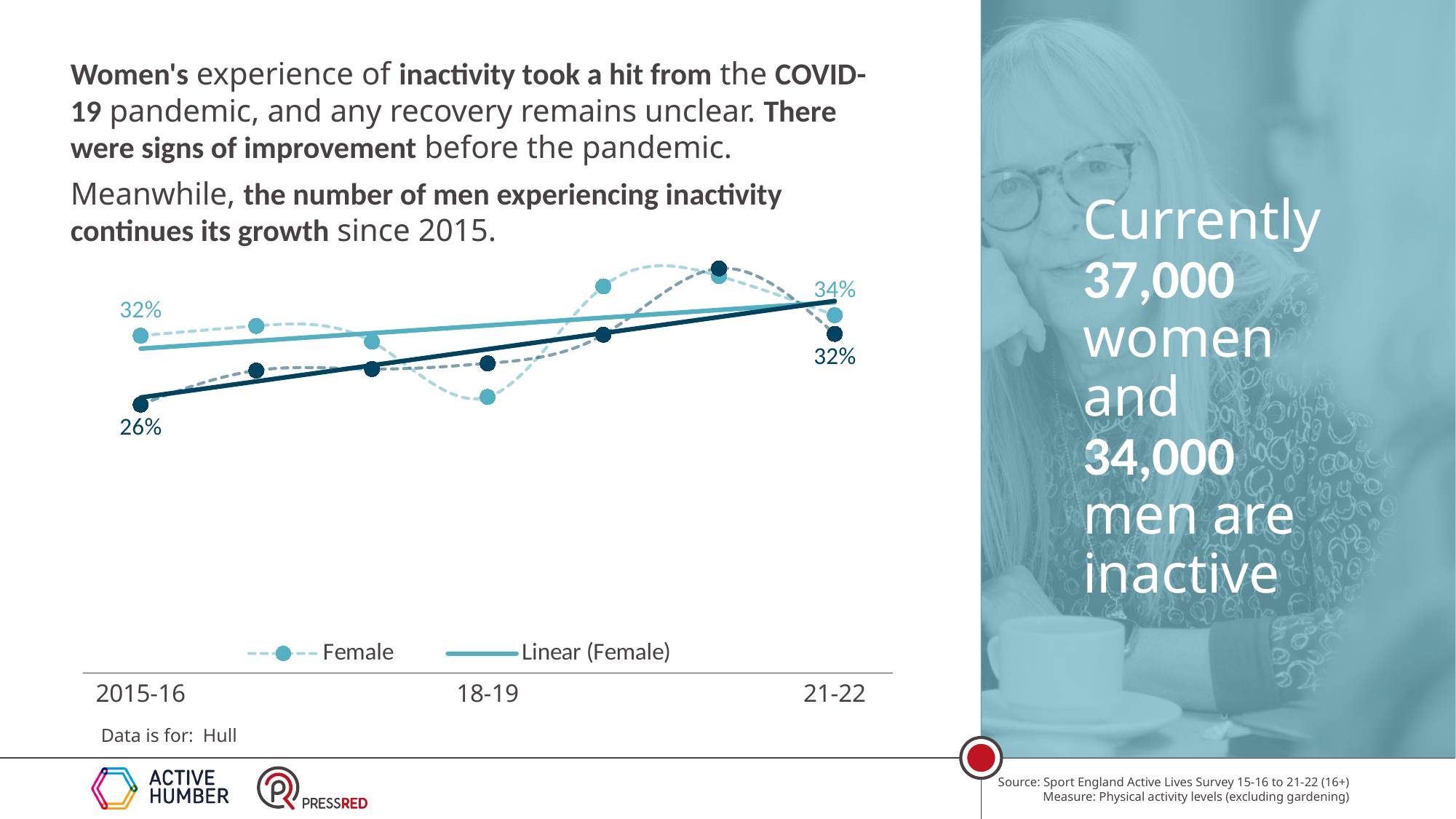
Which area is the chart's data for, according to the note below the chart? Hull By how many percentage points did the dark blue line change from 2015-16 (26%) to 21-22 (32%)? 6 percentage points What is the Female value shown for 21-22? 34% What value is labelled on the dark blue line at 21-22? 32% How many entries does the chart legend list? 2 By how many percentage points did the Female value change from 2015-16 (32%) to 21-22 (34%)? 2 percentage points What kind of chart is shown on the slide? Line chart What is the Female value shown for 2015-16? 32% How many data points does the Female series have? 7 In 2015-16, which is higher: the Female value or the dark blue line's value? Female Does the Linear (Female) trend line rise or fall from 2015-16 to 21-22? Rises What value is labelled on the dark blue line at 2015-16? 26%